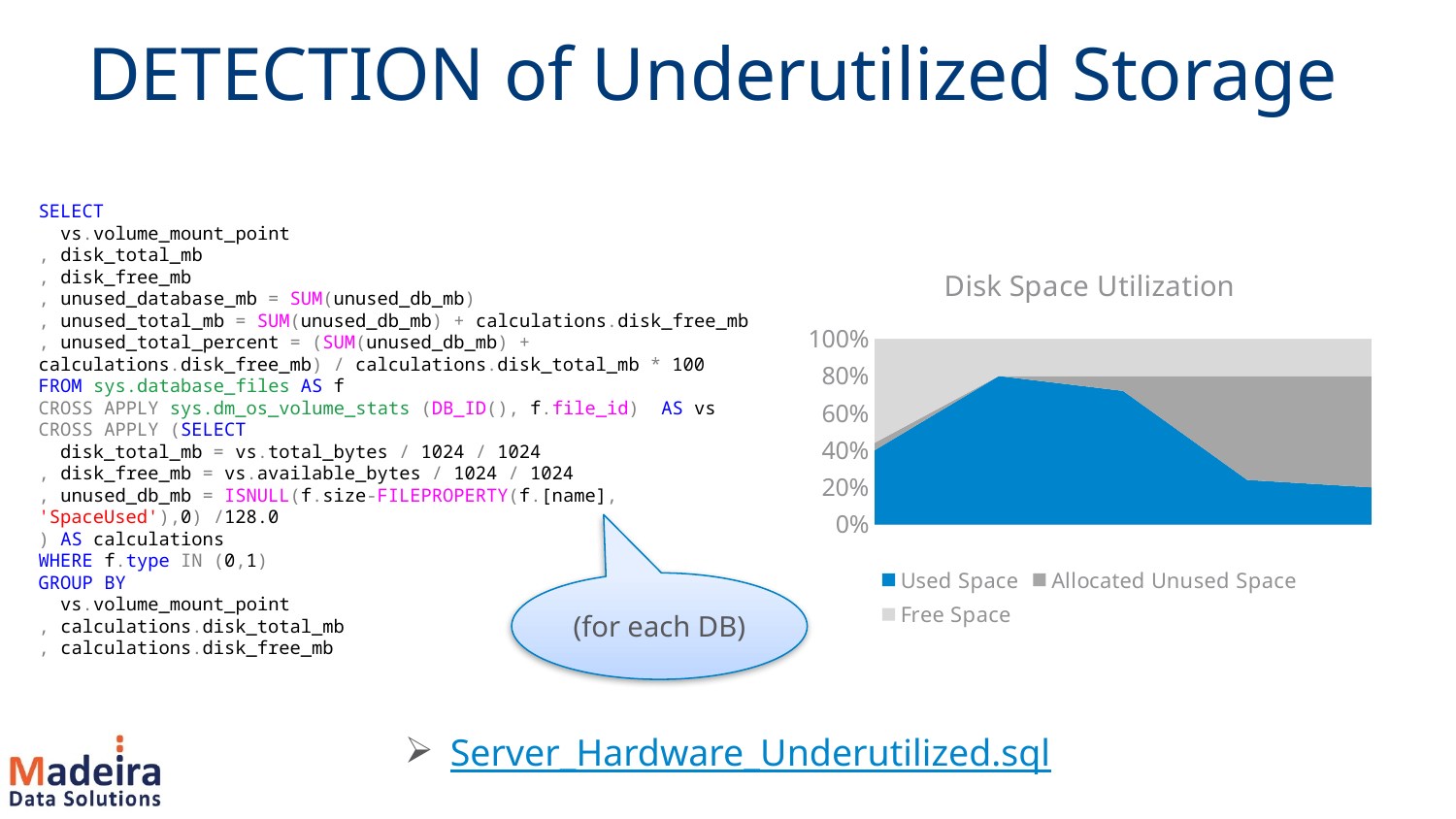
What kind of chart is the Disk Space Utilization chart? Stacked area chart How many series does the legend of the Disk Space Utilization chart list? 3 Is the Used Space value at the right end of the Disk Space Utilization chart greater or less than 40%? less What is the title of the chart on the slide? Disk Space Utilization What is the highest value shown on the y axis of the Disk Space Utilization chart? 100% Is the peak value of Used Space in the Disk Space Utilization chart greater or less than 60%? greater Which series in the Disk Space Utilization chart is shown in blue? Used Space Is the Used Space value at the left end of the Disk Space Utilization chart greater or less than 60%? less In the Disk Space Utilization chart, does Used Space rise or fall from its peak to the right end of the x axis? fall